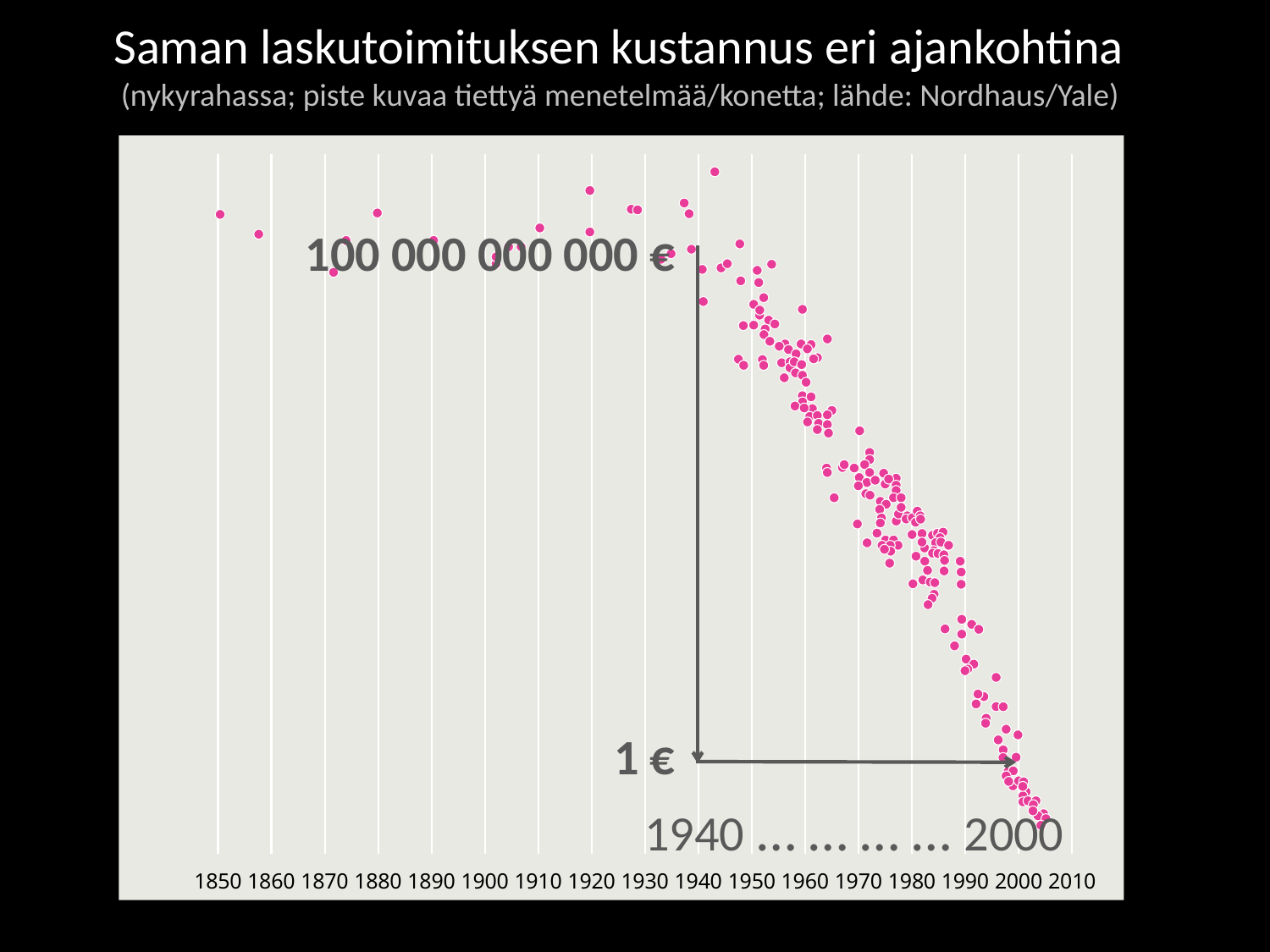
Which two years are named in the horizontal arrow annotation below the chart? 1940 and 2000 What is the first year label shown on the x axis? 1850 Are the points plotted around the year 1940 above or below the 1 € level marked on the chart? above What is the title of the chart on the slide? Saman laskutoimituksen kustannus eri ajankohtina What is the last year label shown on the x axis? 2010 What cost value is written at the bottom of the vertical arrow annotation? 1 € Do the plotted values rise or fall as the years increase along the x axis? fall How many year labels are shown along the x axis? 17 What kind of chart is shown on the slide? scatter chart What cost value is written at the top of the vertical arrow annotation? 100 000 000 000 €